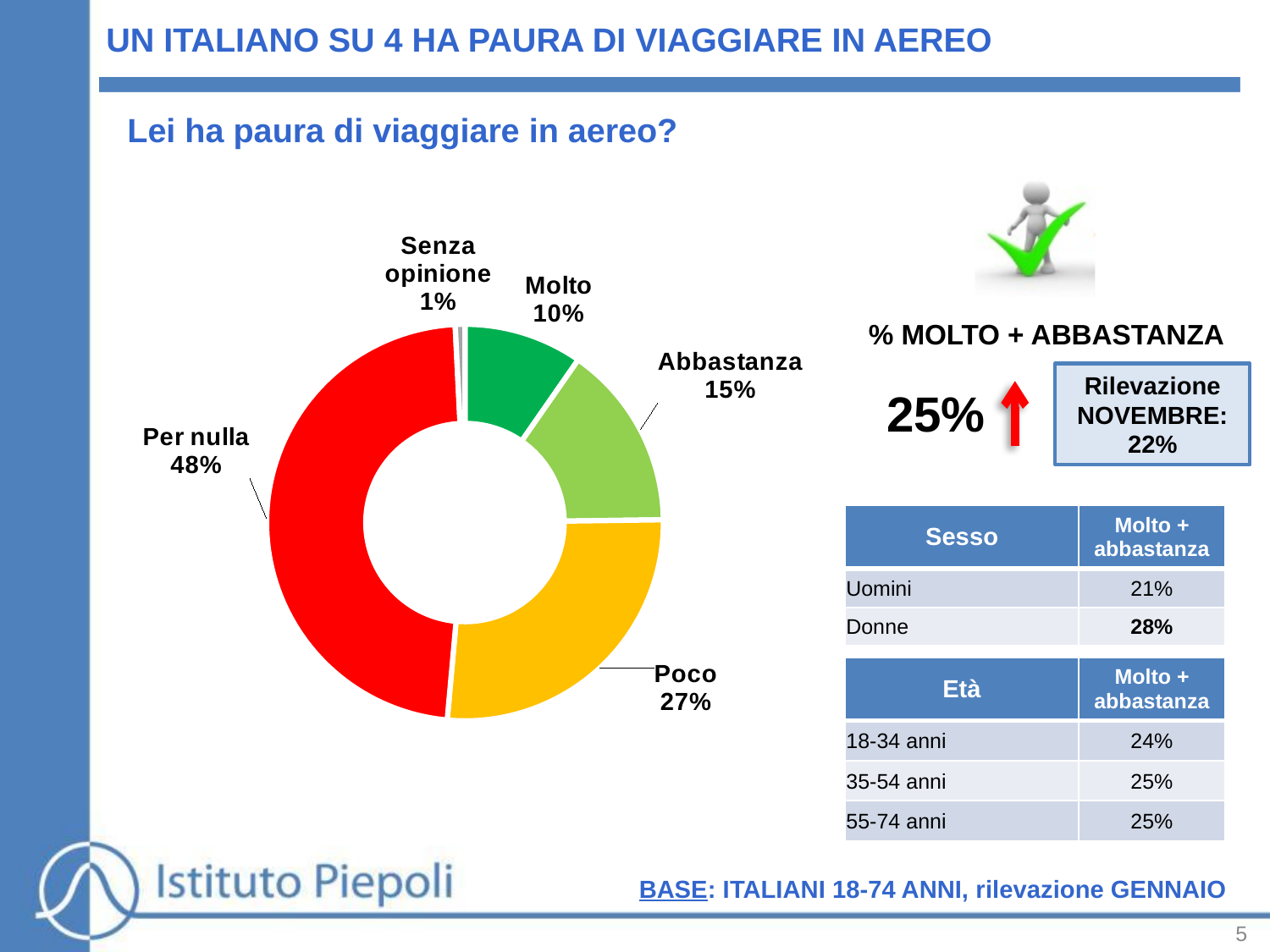
What is the combined share of "Molto" and "Abbastanza"? 25% What percentage of respondents answered "Poco"? 27% Which category has the largest share of the pie? Per nulla What is the difference in percentage points between "Per nulla" and "Poco"? 21 What percentage of respondents answered "Abbastanza"? 15% What colour is the "Per nulla" slice of the pie chart? Red How many categories are shown in the pie chart? 5 What kind of chart is shown on the slide? Pie chart (doughnut) Which category has the smallest share of the pie? Senza opinione What percentage of respondents answered "Molto"? 10% Which is larger, the share for "Abbastanza" or the share for "Molto"? Abbastanza What percentage of respondents answered "Per nulla"? 48%